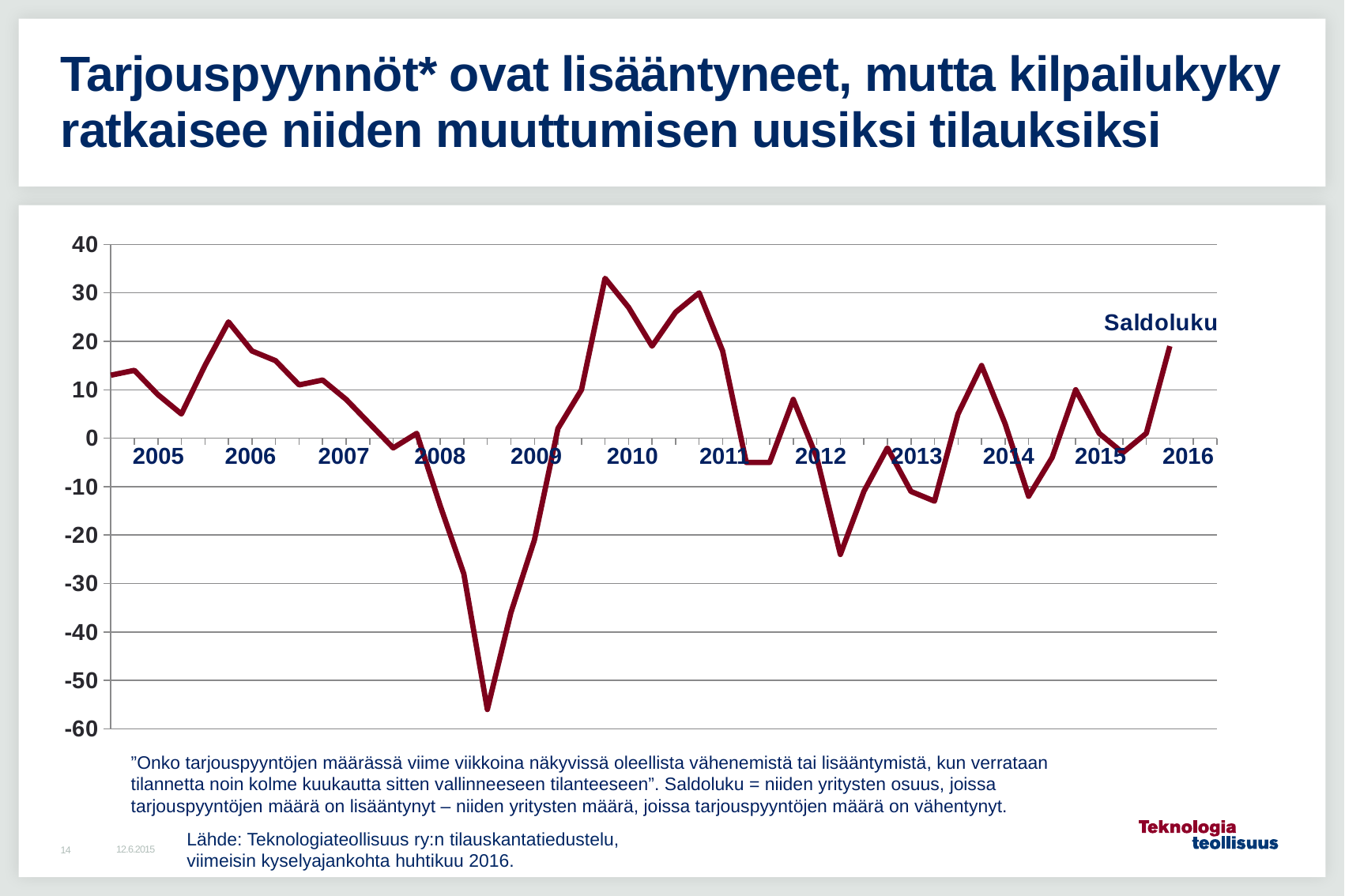
Is the lowest value around 2012 greater or less than -20? less How many year labels are shown on the x axis? 12 What kind of chart is shown on the slide? line chart Which is higher: the peak of the line near 2010 or the peak near 2006? the peak near 2010 Does the line rise or fall between 2008 and the start of 2009? fall Is the lowest point of the line greater or less than -50? less Is the highest point of the line greater or less than 30? greater What is the name of the series plotted on the chart? Saldoluku How many series does the chart show? 1 What is the lowest value shown on the y axis? -60